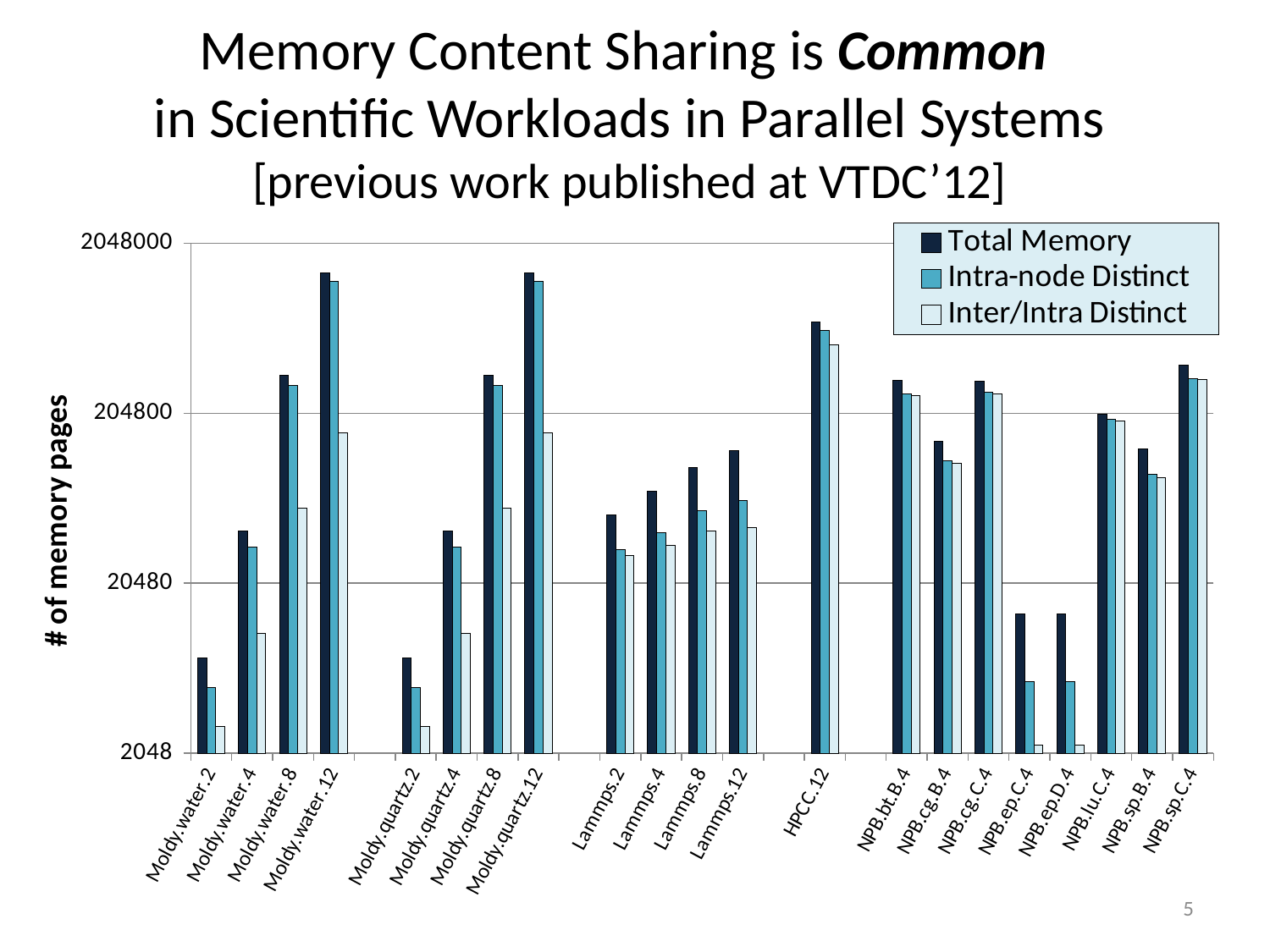
Is the Total Memory value for HPCC.12 greater or less than 204800? greater Which has the larger Total Memory value, HPCC.12 or NPB.sp.C.4? HPCC.12 How many series does the legend list? 3 Is the Inter/Intra Distinct value for NPB.ep.C.4 greater or less than 20480? less Which series is shown with the lightest (near-white) bars in the legend? Inter/Intra Distinct Is the Total Memory value for Moldy.water.12 greater or less than 204800? greater Which of the Lammps categories has the highest Total Memory value? Lammps.12 Does the Total Memory value rise or fall going from Moldy.water.2 to Moldy.water.12? rise How many workload categories are plotted along the x axis? 21 What kind of chart is shown on the slide? bar chart What is the title of the y axis? # of memory pages